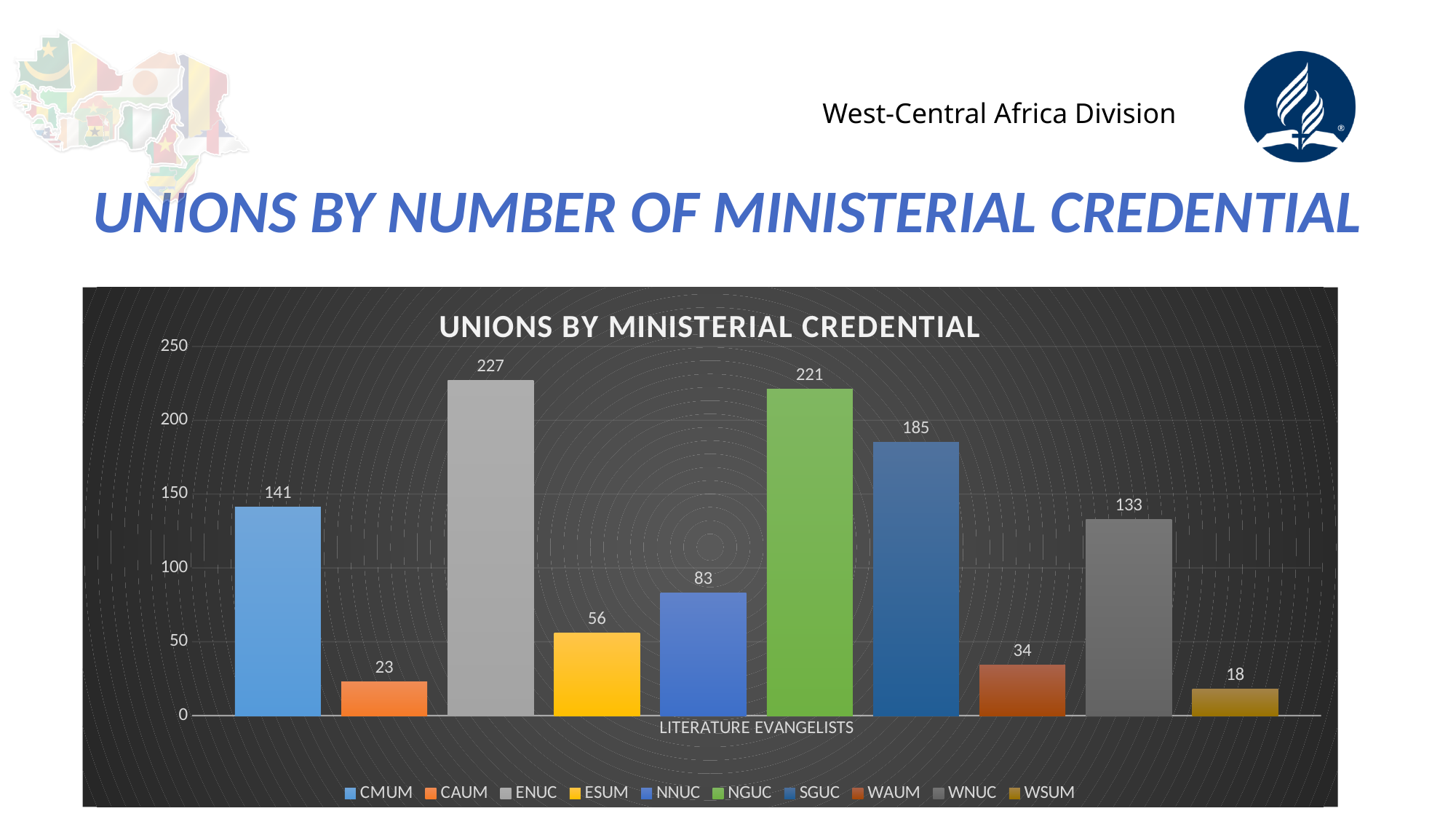
What is the value for SGUC in the chart? 185 Is the value for SGUC greater or less than 150? greater Which is larger, the value for NNUC or the value for ESUM? NNUC What is the difference between the values for ENUC and NGUC? 6 Which union has the highest value in the chart? ENUC What is the value for WSUM in the chart? 18 What is the value for ENUC in the chart? 227 How many series does the legend list? 10 What is the difference between the values for CMUM and WNUC? 8 What kind of chart is shown on the slide? Bar chart What is the title of the chart? UNIONS BY MINISTERIAL CREDENTIAL Which union has the lowest value in the chart? WSUM